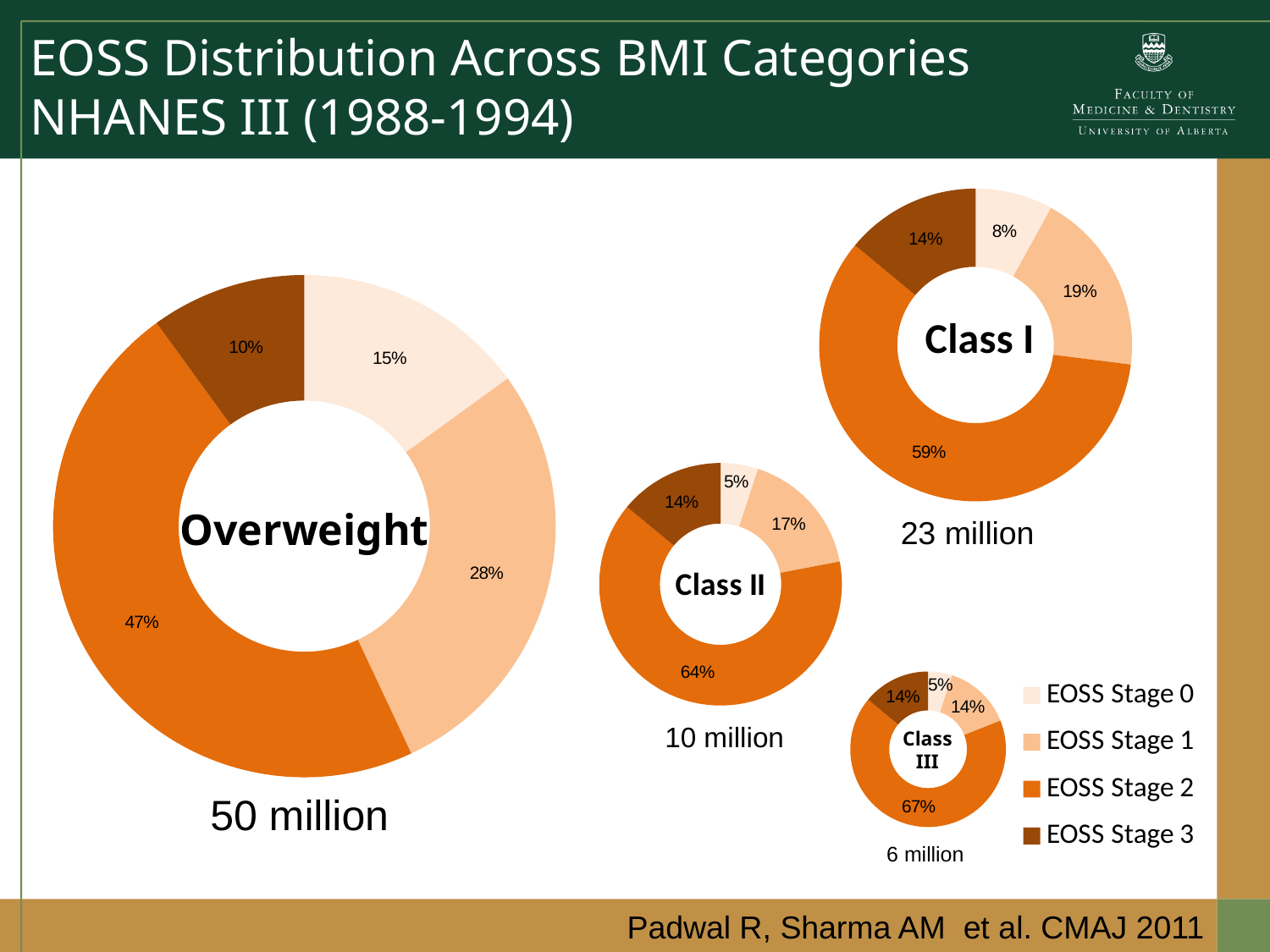
What population size is shown below the Class I chart? 23 million In the Class I chart, which EOSS stage has the smallest share? EOSS Stage 0 In the Overweight chart, what share is EOSS Stage 2? 47% In the Class I chart, what share is EOSS Stage 0? 8% In the Overweight chart, what is the difference between the EOSS Stage 1 and EOSS Stage 0 shares? 13% How many charts are shown on the slide? 4 In the Class II chart, what share is EOSS Stage 1? 17% What kind of chart is used for the Overweight category? Donut chart In the Class III chart, what share is EOSS Stage 2? 67% How many EOSS stages does the legend list? 4 In the Class II chart, which is larger, the EOSS Stage 1 share or the EOSS Stage 3 share? EOSS Stage 1 In the Overweight chart, which EOSS stage has the largest share? EOSS Stage 2